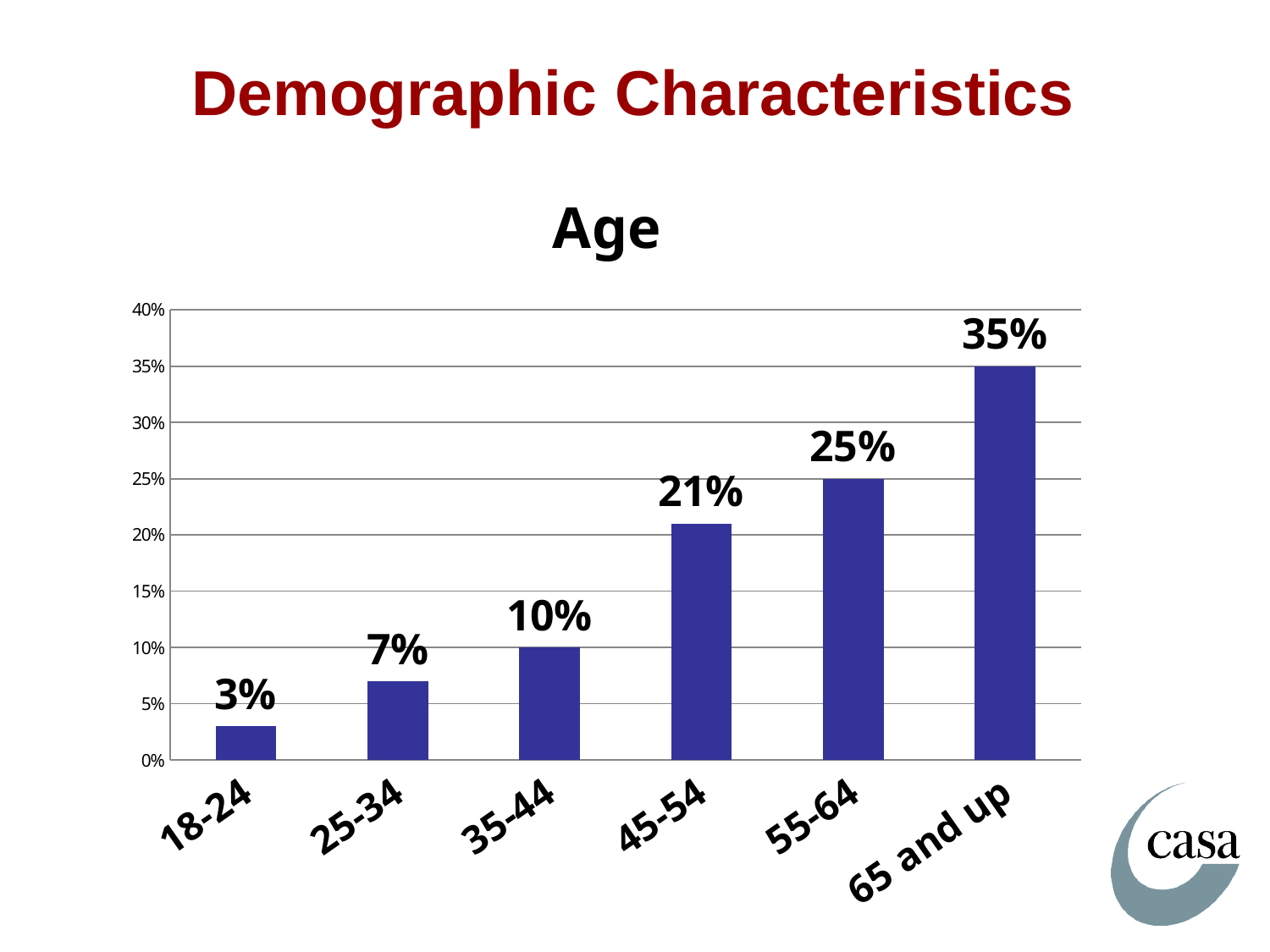
What is the title of the chart? Age How many age groups are shown on the chart? 6 What percentage is shown for the 18-24 age group? 3% What percentage is shown for the 65 and up age group? 35% What is the value for the 45-54 age group? 21% What kind of chart is this? Bar chart What is the difference between the 55-64 and 35-44 age groups? 15% Which age group has the lowest percentage? 18-24 Do the values rise or fall as age increases along the x axis? Rise Which age group has the highest percentage? 65 and up Which is larger, the value for 25-34 or the value for 35-44? 35-44 What is the difference between the 65 and up and 18-24 age groups? 32%